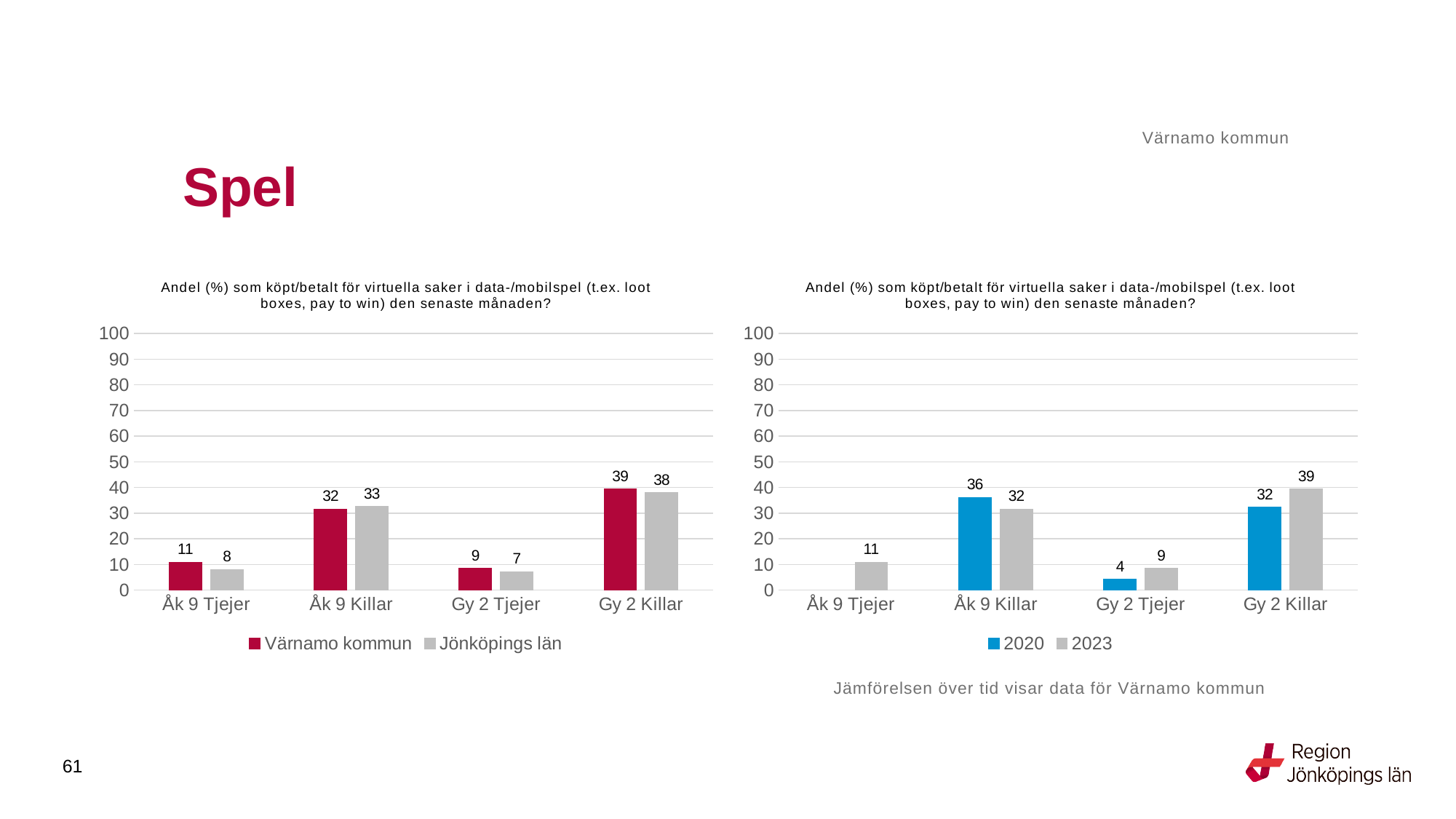
In the right chart, how many categories are shown on the x axis? 4 In the left chart, which category has the highest value for Värnamo kommun? Gy 2 Killar In the right chart, what is the difference between 2023 and 2020 for Gy 2 Killar? 7 In the right chart, what is the value for 2023 for Gy 2 Killar? 39 In the left chart, how many series does the legend list? 2 In the right chart, what is the value for 2020 for Åk 9 Killar? 36 In the left chart, which category has the lowest value for Jönköpings län? Gy 2 Tjejer In the right chart, which is larger for Gy 2 Tjejer: 2020 or 2023? 2023 In the left chart, what is the value for Värnamo kommun for Åk 9 Killar? 32 In the left chart, what is the difference between Värnamo kommun and Jönköpings län for Åk 9 Tjejer? 3 In the left chart, what is the value for Jönköpings län for Gy 2 Tjejer? 7 What kind of chart is the right chart? Bar chart